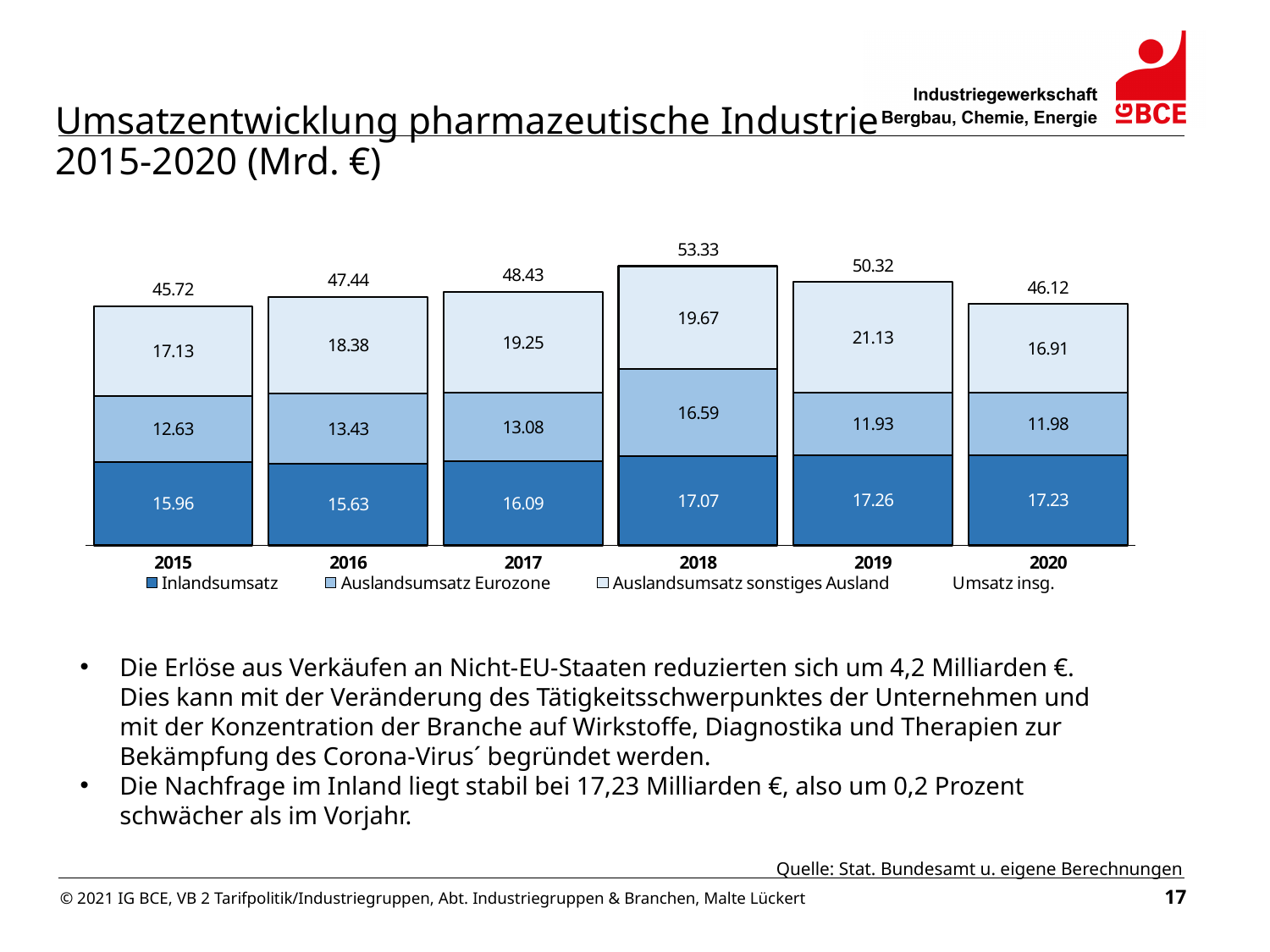
What is the total Umsatz insg. for 2020? 46.12 Which year has the lowest total Umsatz insg.? 2015 Which is larger, the Auslandsumsatz Eurozone value in 2018 or in 2017? 2018 By how much did the Auslandsumsatz sonstiges Ausland value change from 2019 to 2020? 4.22 How many years are shown on the x axis of the chart? 6 What is the Auslandsumsatz sonstiges Ausland value for 2019? 21.13 Which year has the highest total Umsatz insg.? 2018 What is the Auslandsumsatz Eurozone value for 2016? 13.43 Does the total Umsatz insg. rise or fall from 2015 to 2018? rise What is the Inlandsumsatz value for 2018? 17.07 Which series is shown in the darkest blue at the bottom of each bar? Inlandsumsatz What kind of chart is shown on the slide? stacked bar chart